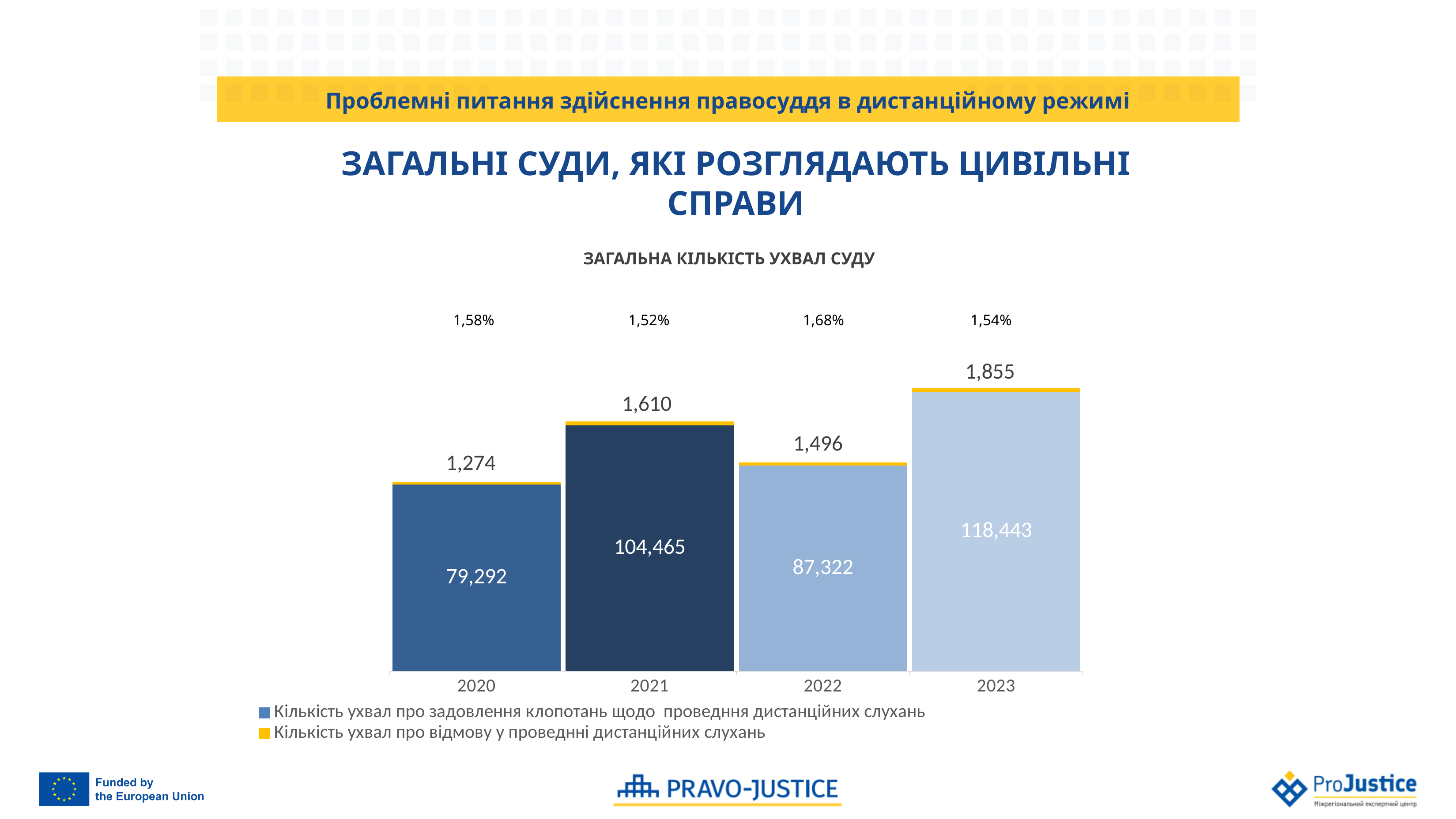
What is the total of the stacked bar for 2020 (granting plus refusing rulings)? 80,566 What is the difference between the number of rulings granting remote hearings in 2023 and in 2020? 39,151 What is the number of rulings refusing remote hearings (yellow series) in 2023? 1,855 What is the number of rulings granting motions for remote hearings (blue series) in 2021? 104,465 In which year is the number of rulings granting motions for remote hearings the highest? 2023 What is the title of the chart? ЗАГАЛЬНА КІЛЬКІСТЬ УХВАЛ СУДУ What percentage is shown above the bar for 2022? 1,68% What type of chart is shown on the slide? Stacked bar chart How many series does the chart legend list? 2 In which year is the number of rulings refusing remote hearings the lowest? 2020 Which year has more rulings granting remote hearings, 2021 or 2022? 2021 How many years are shown on the x axis of the chart? 4